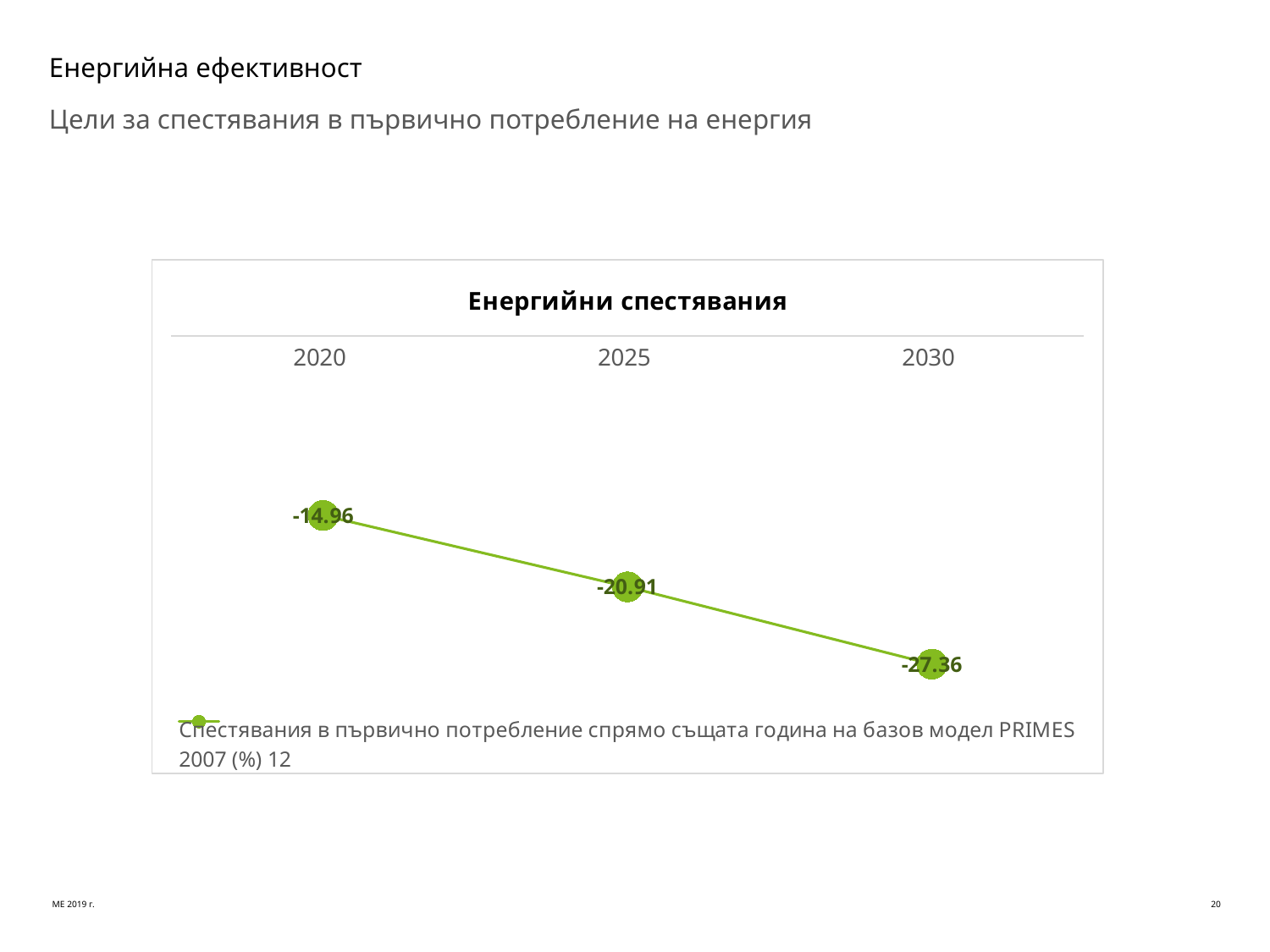
How many data points are plotted in the Енергийни спестявания chart? 3 What is the value for 2030 in the Енергийни спестявания chart? -27.36 Which year has the lowest value in the Енергийни спестявания chart? 2030 What is the value for 2025 in the Енергийни спестявания chart? -20.91 Which is larger, the value for 2020 or the value for 2025 in the Енергийни спестявания chart? 2020 What is the value for 2020 in the Енергийни спестявания chart? -14.96 Do the values in the Енергийни спестявания chart rise or fall from 2020 to 2030? fall What kind of chart is the Енергийни спестявания chart? line chart What is the difference between the values for 2020 and 2030 in the Енергийни спестявания chart? 12.4 How many series does the legend of the Енергийни спестявания chart list? 1 What is the difference between the values for 2025 and 2030 in the Енергийни спестявания chart? 6.45 Which year has the highest value in the Енергийни спестявания chart? 2020